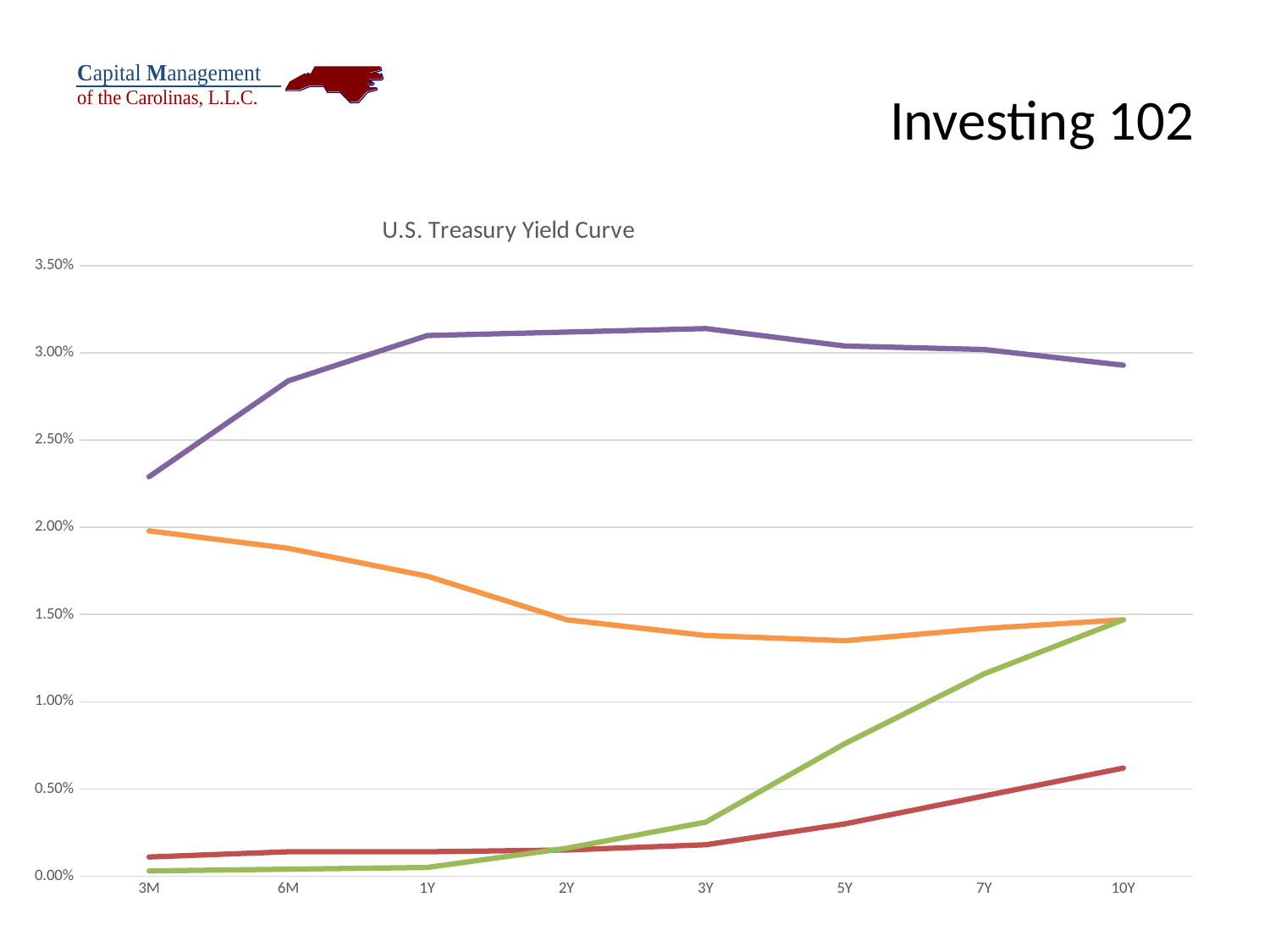
What kind of chart is shown on the slide? line chart Which line has the highest value at 10Y, the purple line or the red line? purple line How many lines are plotted on the chart? 4 How many categories are shown on the x axis of the chart? 8 Is the value of the purple line at 1Y greater or less than 3.00%? greater Does the green line rise or fall from 3Y to 10Y? rise Is the value of the orange line at 5Y greater or less than 1.50%? less What is the title of the chart? U.S. Treasury Yield Curve Is the value of the red line at 10Y greater or less than 1.00%? less Does the orange line rise or fall from 3M to 5Y? fall